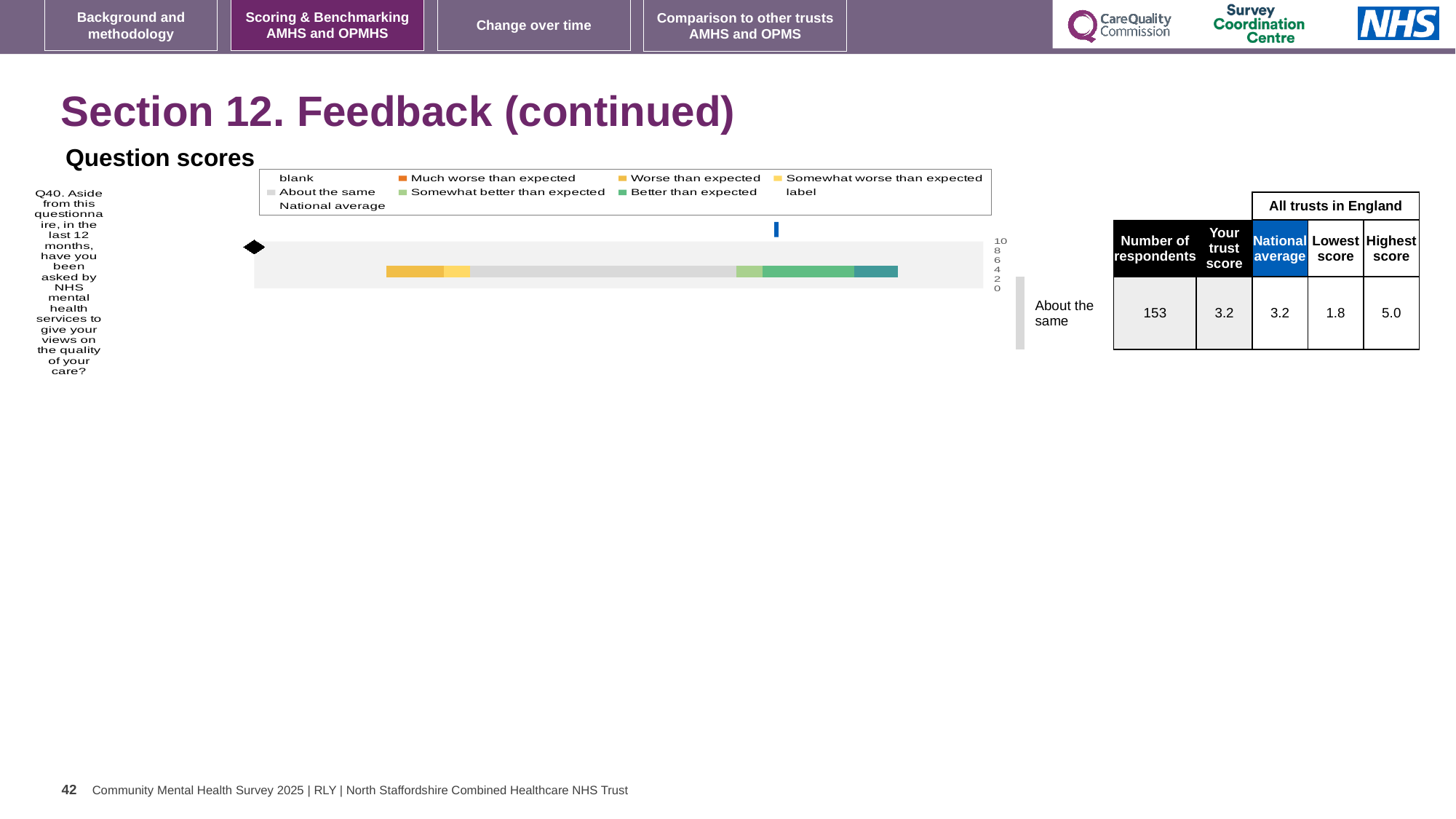
What is the national average for Q40 shown beside the chart? 3.2 Which legend entry in the Question scores chart is shown in grey? About the same What is the lowest score among all trusts in England for Q40? 1.8 What is the number of respondents for Q40 shown beside the chart? 153 How many questions (categories) are plotted in the Question scores chart? 1 How many entries does the legend of the Question scores chart list? 9 What is the trust score for Q40 shown beside the chart? 3.2 Which question is plotted in the Question scores chart? Q40 What benchmark category is shown for Q40 next to the chart? About the same For Q40, what is the difference between the highest score and the lowest score among all trusts in England? 3.2 What kind of chart is shown under 'Question scores'? bar chart What is the highest score among all trusts in England for Q40? 5.0